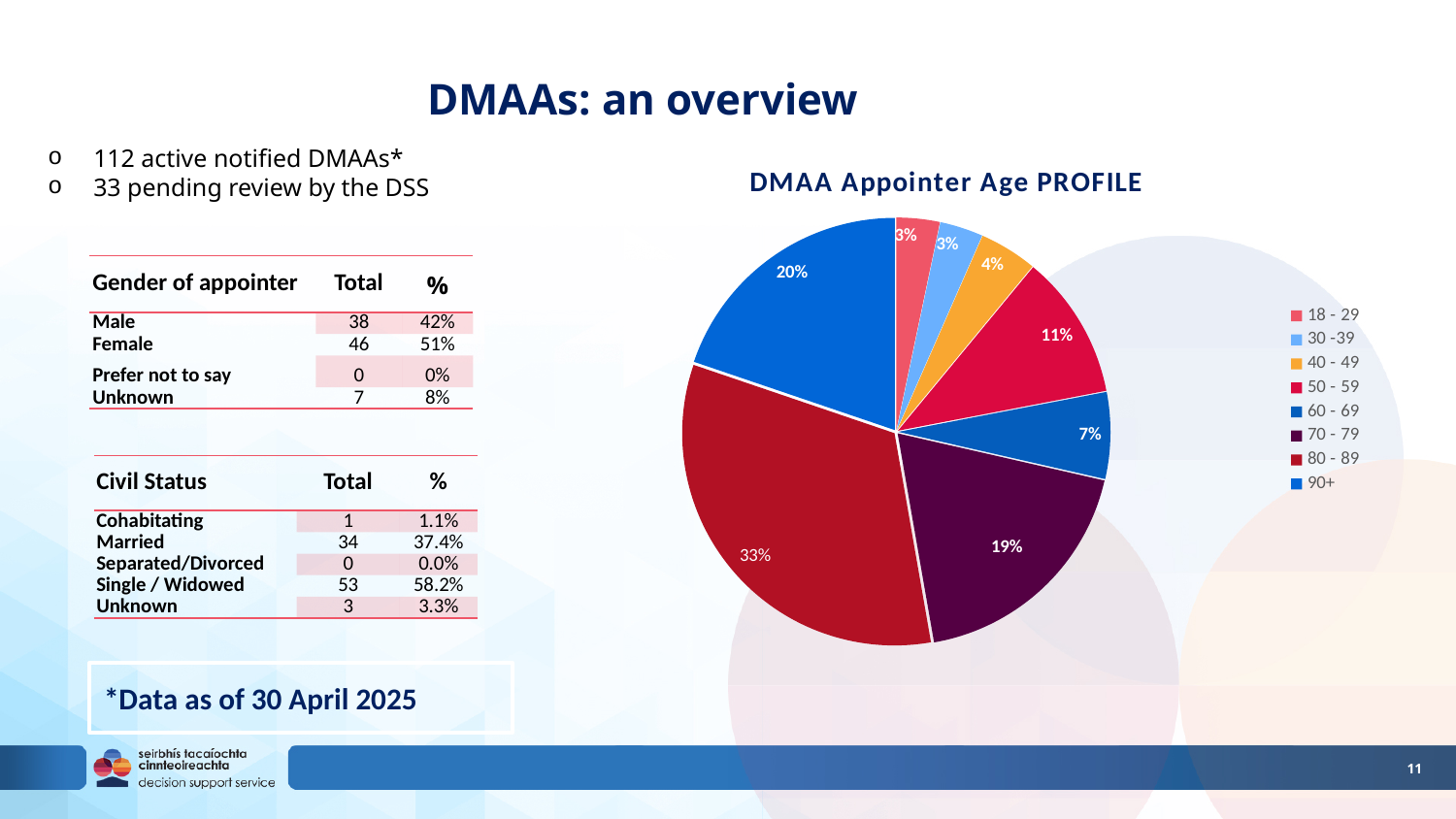
In the DMAA Appointer Age PROFILE pie chart, what percentage is shown for the 40 - 49 age group? 4% In the DMAA Appointer Age PROFILE pie chart, what percentage is shown for the 60 - 69 age group? 7% In the DMAA Appointer Age PROFILE pie chart, what percentage is shown for the 50 - 59 age group? 11% In the DMAA Appointer Age PROFILE pie chart, what percentage is shown for the 80 - 89 age group? 33% In the DMAA Appointer Age PROFILE pie chart, what percentage is shown for the 70 - 79 age group? 19% What share of the DMAA Appointer Age PROFILE pie does the 90+ slice represent? 20% In the DMAA Appointer Age PROFILE pie chart, what is the difference in percentage points between the 80 - 89 slice and the 70 - 79 slice? 14% What is the title of the pie chart on the slide? DMAA Appointer Age PROFILE In the DMAA Appointer Age PROFILE pie chart, which slice is larger: 50 - 59 or 60 - 69? 50 - 59 How many age groups are listed in the legend of the DMAA Appointer Age PROFILE pie chart? 8 Which age group has the largest slice in the DMAA Appointer Age PROFILE pie chart? 80 - 89 What kind of chart is shown under the title "DMAA Appointer Age PROFILE"? pie chart